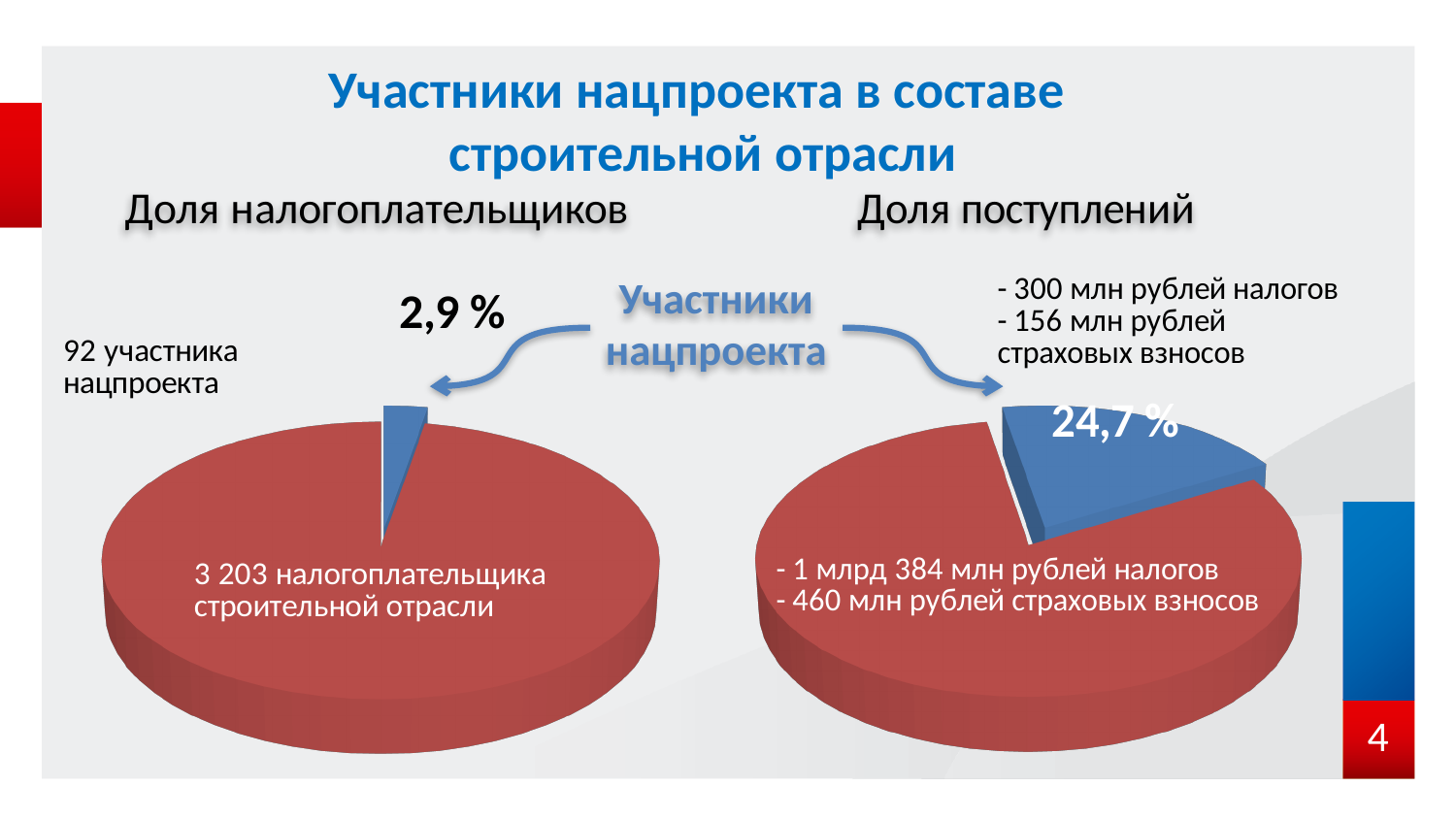
What kind of chart is used for "Доля налогоплательщиков" on the left of the slide? pie chart How many slices does the "Доля налогоплательщиков" pie chart have? 2 In the "Доля поступлений" chart, how many рублей налогов are attributed to the участники нацпроекта (blue slice)? 300 млн рублей In the "Доля поступлений" chart, how many рублей страховых взносов are attributed to the участники нацпроекта (blue slice)? 156 млн рублей In the "Доля поступлений" chart, how many рублей страховых взносов are shown for the red slice? 460 млн рублей In the "Доля поступлений" chart, how many рублей налогов are shown for the red slice? 1 млрд 384 млн рублей In the "Доля поступлений" chart, what share of the pie do the участники нацпроекта hold? 24,7 % Which chart shows a larger share for the участники нацпроекта, "Доля налогоплательщиков" or "Доля поступлений"? Доля поступлений In the "Доля налогоплательщиков" chart, how many участники нацпроекта are shown for the blue slice? 92 In the "Доля налогоплательщиков" chart, what share of the pie do the участники нацпроекта hold? 2,9 % What kind of chart is used for "Доля поступлений" on the right of the slide? pie chart In the "Доля налогоплательщиков" chart, how many налогоплательщики строительной отрасли are shown for the red slice? 3 203